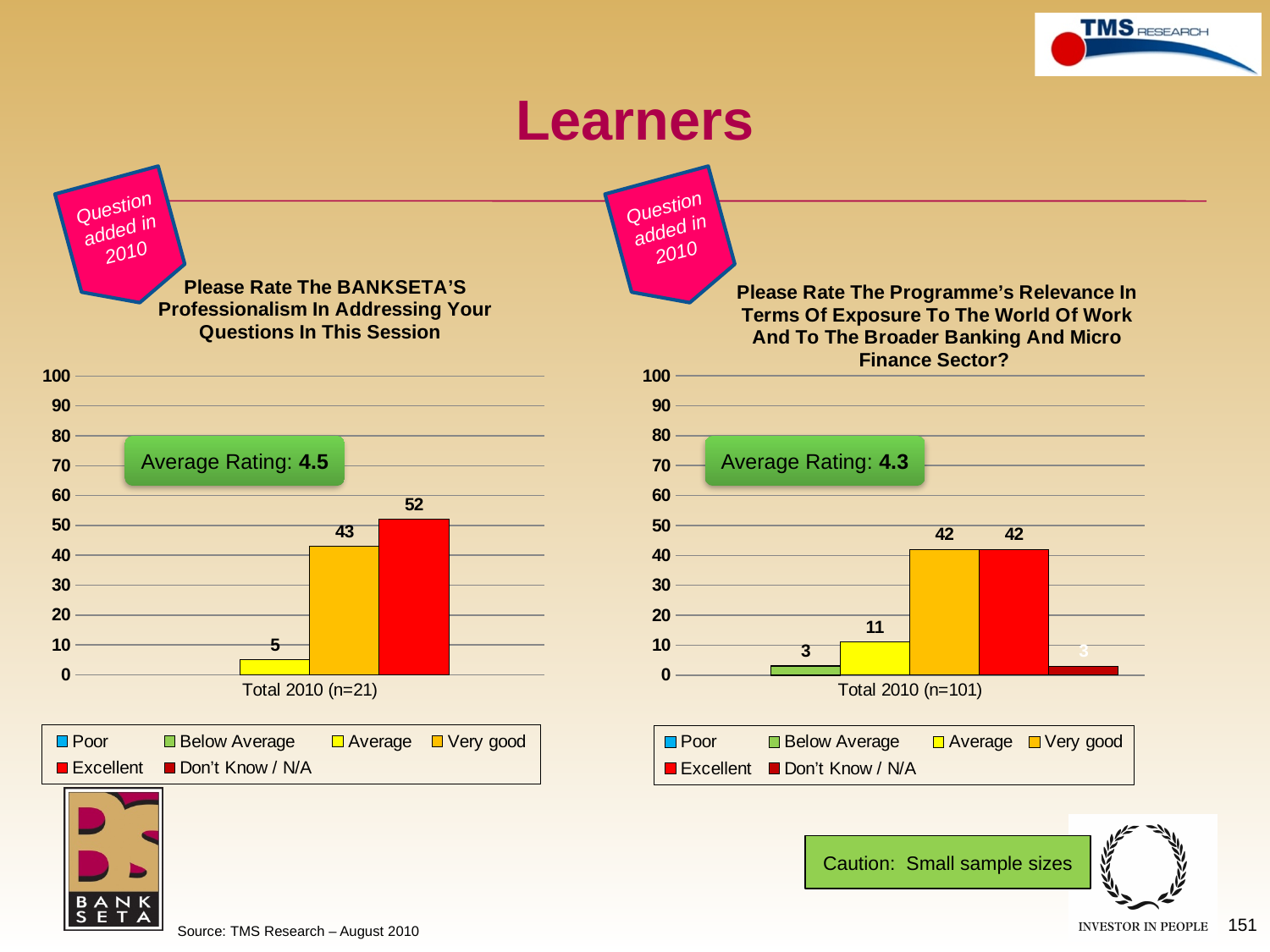
In the left chart (BANKSETA's Professionalism), what is the value for Excellent? 52 In the left chart (BANKSETA's Professionalism), what is the difference between the Excellent and Very good values? 9 In the left chart (BANKSETA's Professionalism), which rating category has the highest value? Excellent In the left chart (BANKSETA's Professionalism), what is the sample size shown on the x-axis label? n=21 What average rating is shown for the right chart (Programme's Relevance)? 4.3 In the right chart (Programme's Relevance), which rating category has the lowest value among the plotted bars? Below Average and Don't Know / N/A (both 3) In the right chart (Programme's Relevance), is the value for Very good greater or less than 40? greater In the right chart (Programme's Relevance), what is the value for Below Average? 3 In the left chart (BANKSETA's Professionalism), what is the value for Very good? 43 In the right chart (Programme's Relevance), what is the value for Average? 11 What kind of chart is used on the left side of the slide? Bar chart In the right chart (Programme's Relevance), how many series does the legend list? 6